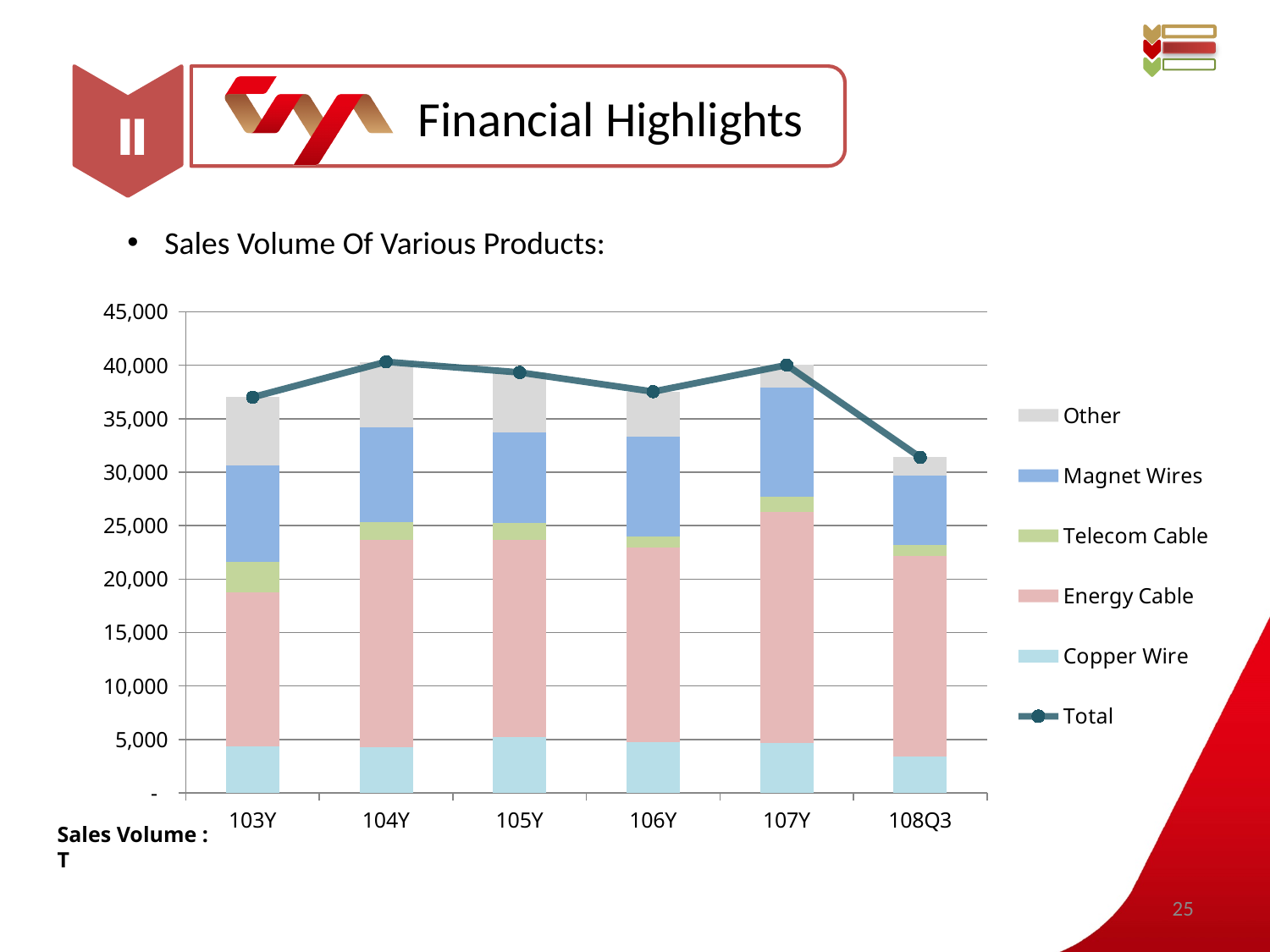
How many categories are shown on the x axis of the chart? 6 Which series is shown as a line rather than as stacked bars? Total What unit label is shown below the x axis of the chart? Sales Volume : T Is the Total value for 108Q3 greater or less than 30,000? greater Is the Total value for 106Y greater or less than 35,000? greater Is the Total value for 108Q3 greater or less than 35,000? less How many series does the chart's legend list? 6 Which category has the lowest Total value? 108Q3 What kind of chart is shown on the slide? Stacked bar chart with a line for Total Does the Total line rise or fall from 107Y to 108Q3? fall Which is larger, the Total value for 103Y or for 108Q3? 103Y